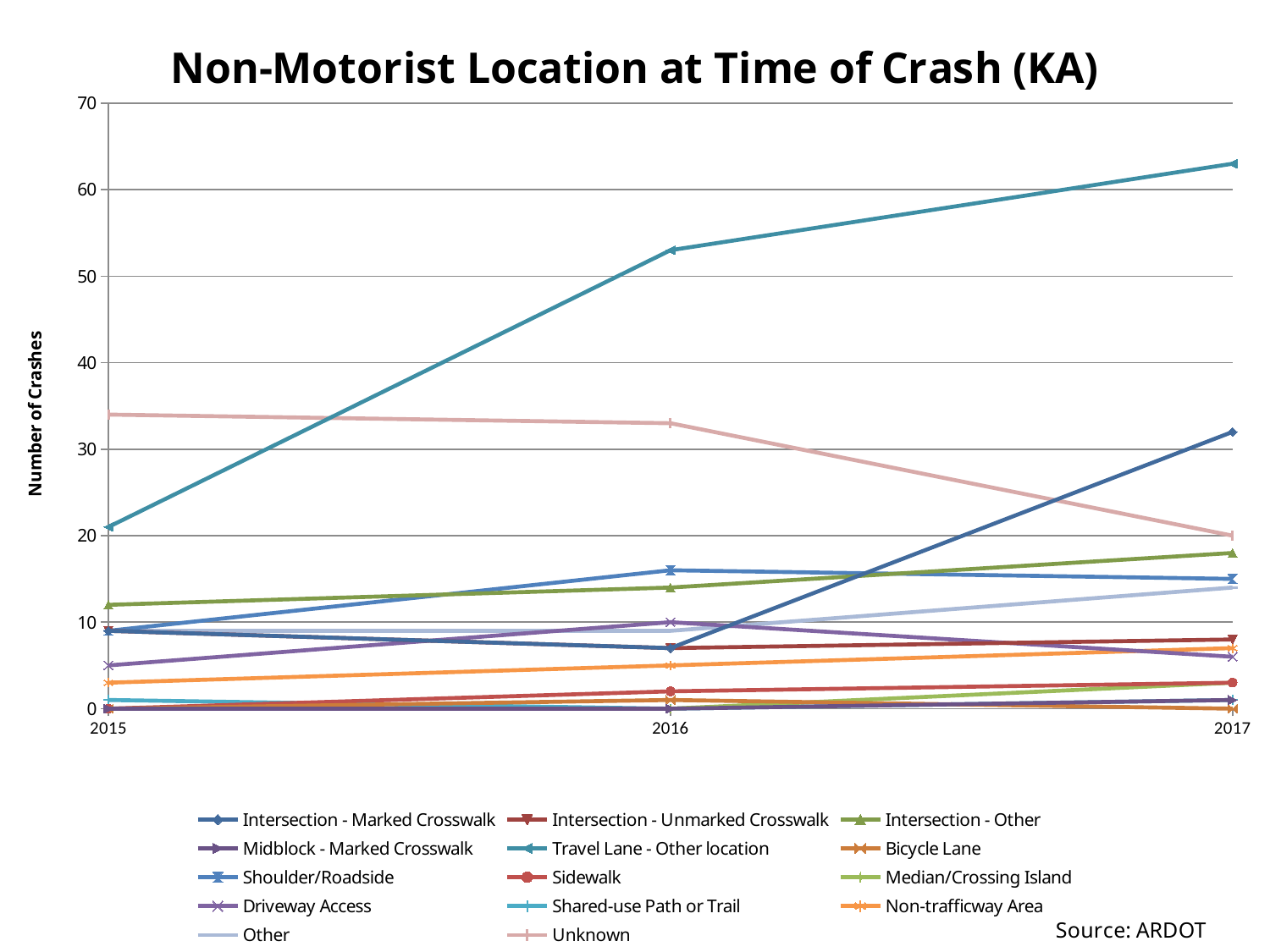
Is the value for Unknown in 2015 greater or less than 30? greater What is the title of the y axis? Number of Crashes In 2015, which is larger: Unknown or Travel Lane - Other location? Unknown How many years are plotted along the x axis? 3 Is the value for Travel Lane - Other location in 2016 greater or less than 50? greater Which series has the highest value in 2017? Travel Lane - Other location Is the value for Intersection - Marked Crosswalk in 2017 greater or less than 30? greater Which series has the highest value in 2015? Unknown What type of chart is shown on the slide? Line chart Does the Travel Lane - Other location series rise or fall from 2015 to 2017? Rises How many series does the legend list? 14